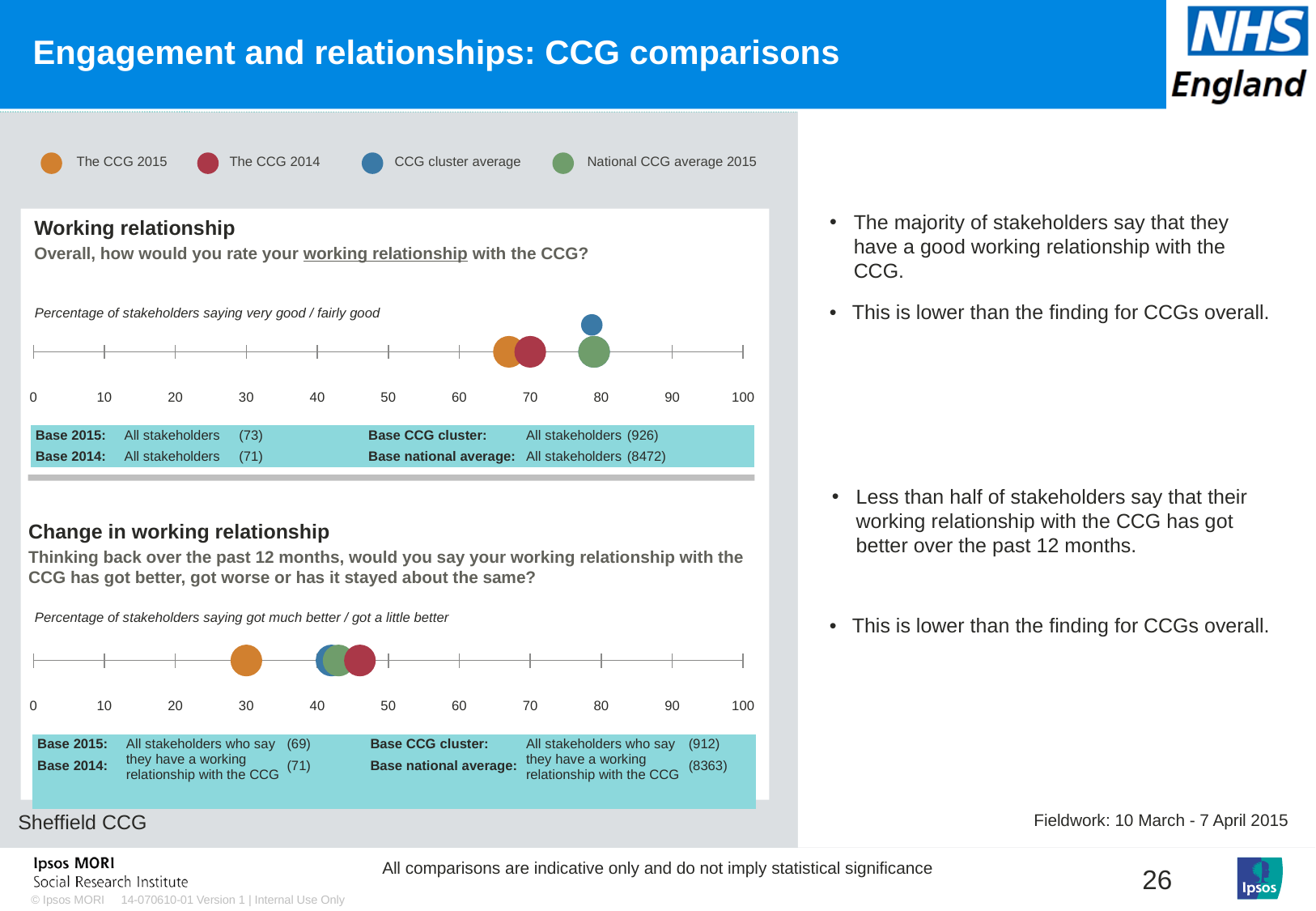
In the 'Working relationship' chart, which is larger: The CCG 2015 or the National CCG average 2015? National CCG average 2015 In the 'Working relationship' chart, what is the base for 2015 (all stakeholders)? 73 In the 'Change in working relationship' chart, is the value for The CCG 2014 greater or less than 40? greater In the 'Working relationship' chart, is the value for CCG cluster average greater or less than 70? greater In the 'Working relationship' chart, is the value for The CCG 2015 greater or less than 60? greater In the 'Change in working relationship' chart, which is larger: The CCG 2015 or the CCG cluster average? CCG cluster average What is the maximum value shown on the axis of the 'Working relationship' chart? 100 In the 'Change in working relationship' chart, which series has the lowest value? The CCG 2015 In the 'Change in working relationship' chart, what is the base for the national average? 8363 What kind of chart is the 'Working relationship' chart? dot plot How many series does the legend list for the charts on this slide? 4